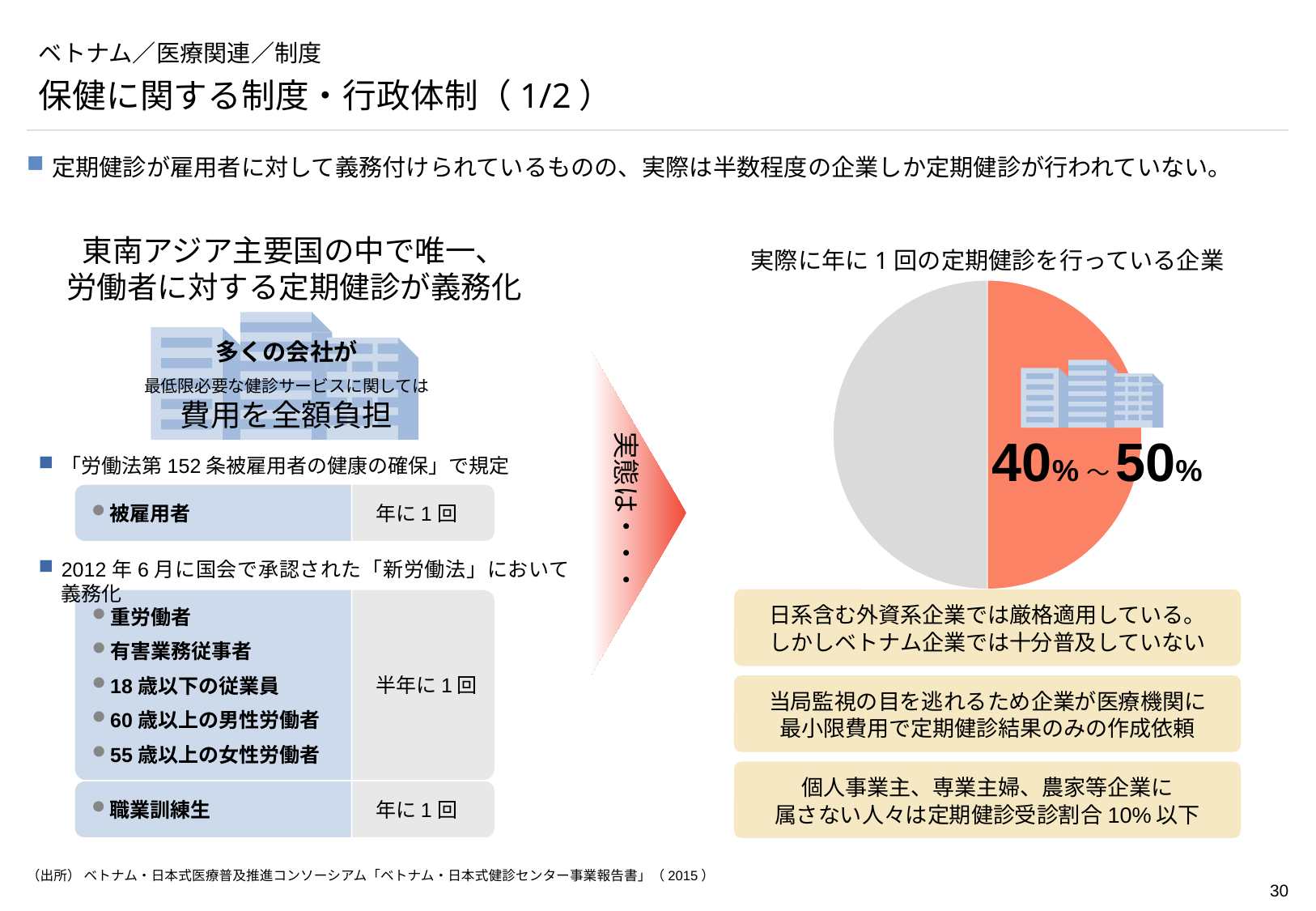
What is the title of the pie chart on the slide? 実際に年に1回の定期健診を行っている企業 What value is printed on the red slice of the pie chart? 40%～50% According to the pie chart, what share of companies actually conduct an annual health check-up? 40%～50% What kind of chart is shown on the right side of the slide? pie chart How many slices does the pie chart have? 2 What colour is the slice of the pie chart that carries the printed percentage label? red